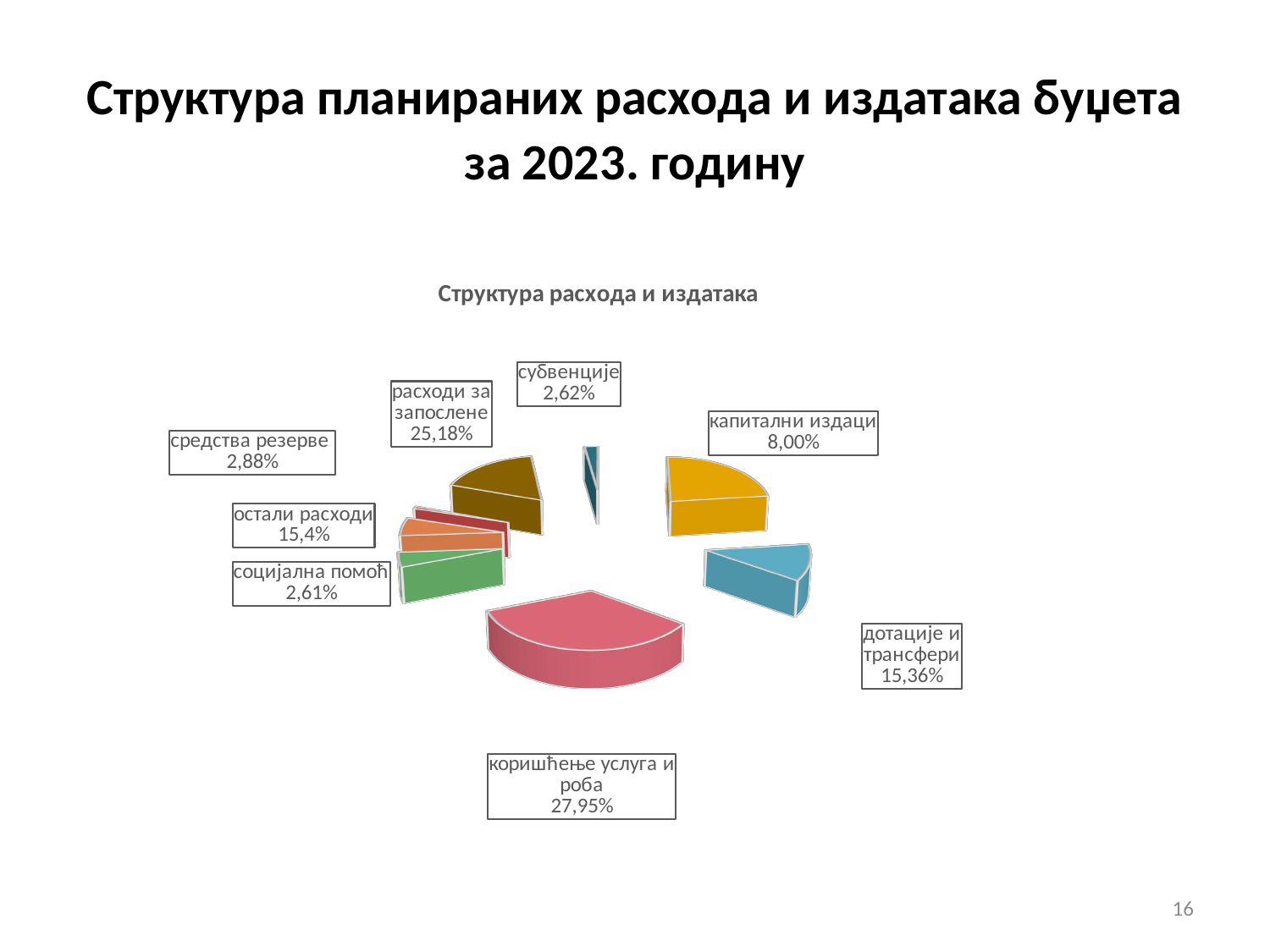
What share is shown for средства резерве? 2,88% What is the title of the chart? Структура расхода и издатака What type of chart is shown on the slide? pie chart What is the value shown for расходи за запослене? 25,18% Which category has the largest share of the pie? коришћење услуга и роба Which is larger, the share for остали расходи or the share for дотације и трансфери? остали расходи What share of the pie does коришћење услуга и роба have? 27,95% What is the difference between the shares of коришћење услуга и роба and расходи за запослене? 2,77% Which category has the smallest share of the pie? социјална помоћ What percentage is shown for капитални издаци? 8,00% What is the value for дотације и трансфери? 15,36% How many categories are shown in the pie chart? 8